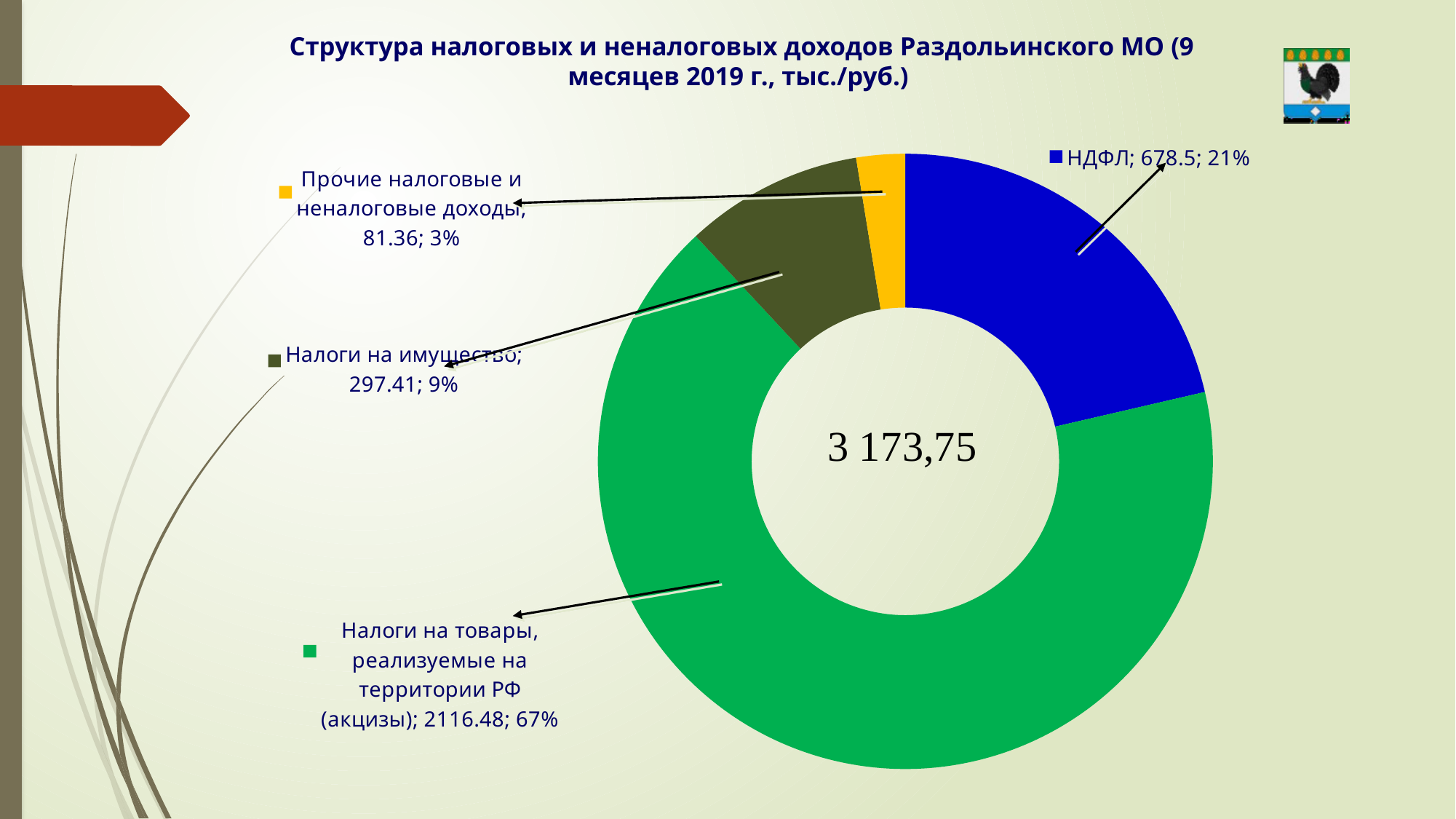
Which is larger, the value for НДФЛ or the value for Налоги на имущество? НДФЛ What is the value for Налоги на имущество? 297.41 Which category has the smallest share of the chart? Прочие налоговые и неналоговые доходы What share of the chart does Налоги на имущество represent? 9% What kind of chart is shown on the slide? doughnut (pie) chart How many categories does the chart show? 4 What is the difference between the values for НДФЛ and Налоги на имущество? 381.09 What is the value for НДФЛ? 678.5 Which category has the largest share of the chart? Налоги на товары, реализуемые на территории РФ (акцизы) What is the value for Налоги на товары, реализуемые на территории РФ (акцизы)? 2116.48 What share of the chart does НДФЛ represent? 21% What is the value for Прочие налоговые и неналоговые доходы? 81.36